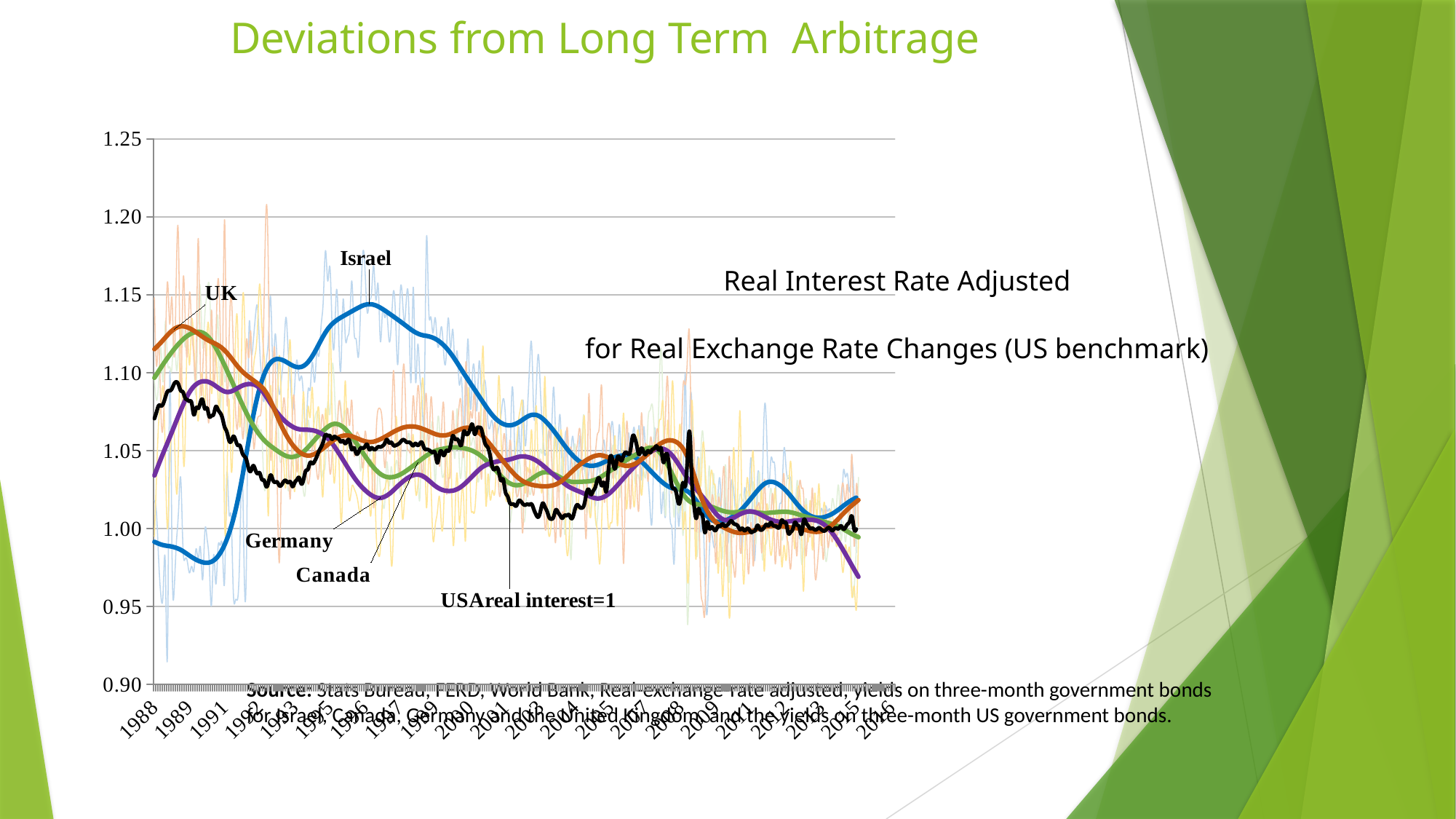
How many labeled series are shown on the chart? 5 What is the highest value shown on the vertical axis? 1.25 Is the value of the Canada line at the far right of the chart (2016) greater or less than 1.00? less Which labeled series reaches the highest value on the chart? Israel Is the value of the Israel line around 1990 greater or less than 1.00? less What kind of chart is shown on the slide? line chart What is the first year shown on the horizontal axis? 1988 Around 1989, which is larger: the UK line or the Israel line? UK Does the Israel line rise or fall between 1997 and 2010? fall Is the peak value of the Israel line (around 1997) greater or less than 1.10? greater Around 1997, which is larger: the Israel line or the UK line? Israel